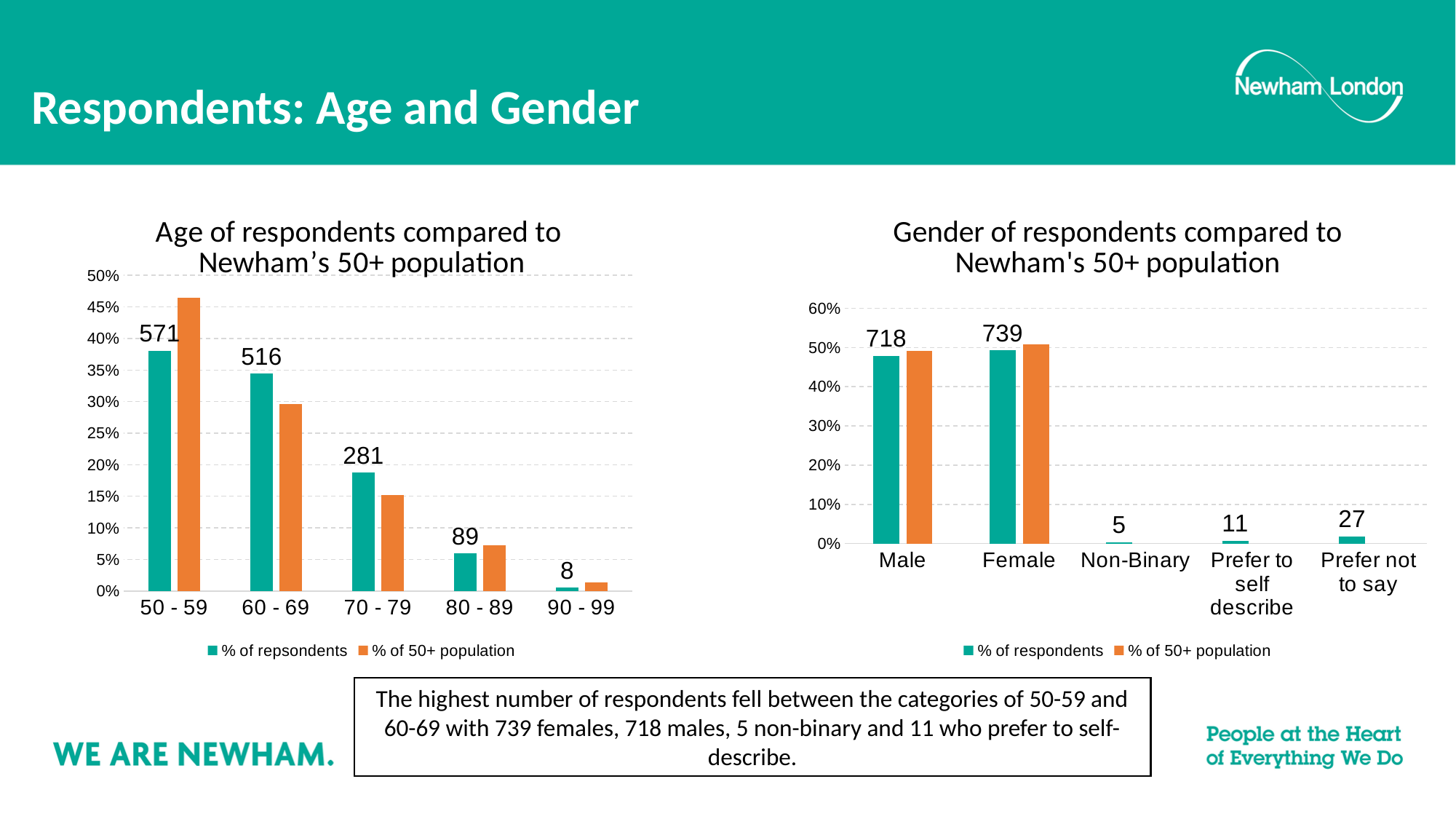
On the 'Gender of respondents' chart, which category has the lowest number of respondents? Non-Binary On the 'Age of respondents' chart, what is the difference between the respondent counts for 50 - 59 and 60 - 69? 55 On the 'Age of respondents' chart, which age group has the highest number of respondents? 50 - 59 On the 'Age of respondents' chart, for the 50 - 59 group, which bar is taller: % of respondents or % of 50+ population? % of 50+ population On the 'Gender of respondents' chart, is the % of respondents value for Male greater or less than 40%? greater On the 'Age of respondents' chart, what data label is shown for the 50 - 59 age group? 571 On the 'Age of respondents' chart, do the % of respondents values rise or fall as the age groups increase? fall On the 'Gender of respondents' chart, what is the difference between the Female and Male respondent counts? 21 On the 'Gender of respondents' chart, what data label is shown for Prefer not to say? 27 On the 'Age of respondents' chart, is the % of respondents value for 50 - 59 greater or less than 35%? greater How many age groups are shown on the 'Age of respondents' chart? 5 How many series does the legend of the 'Gender of respondents' chart list? 2